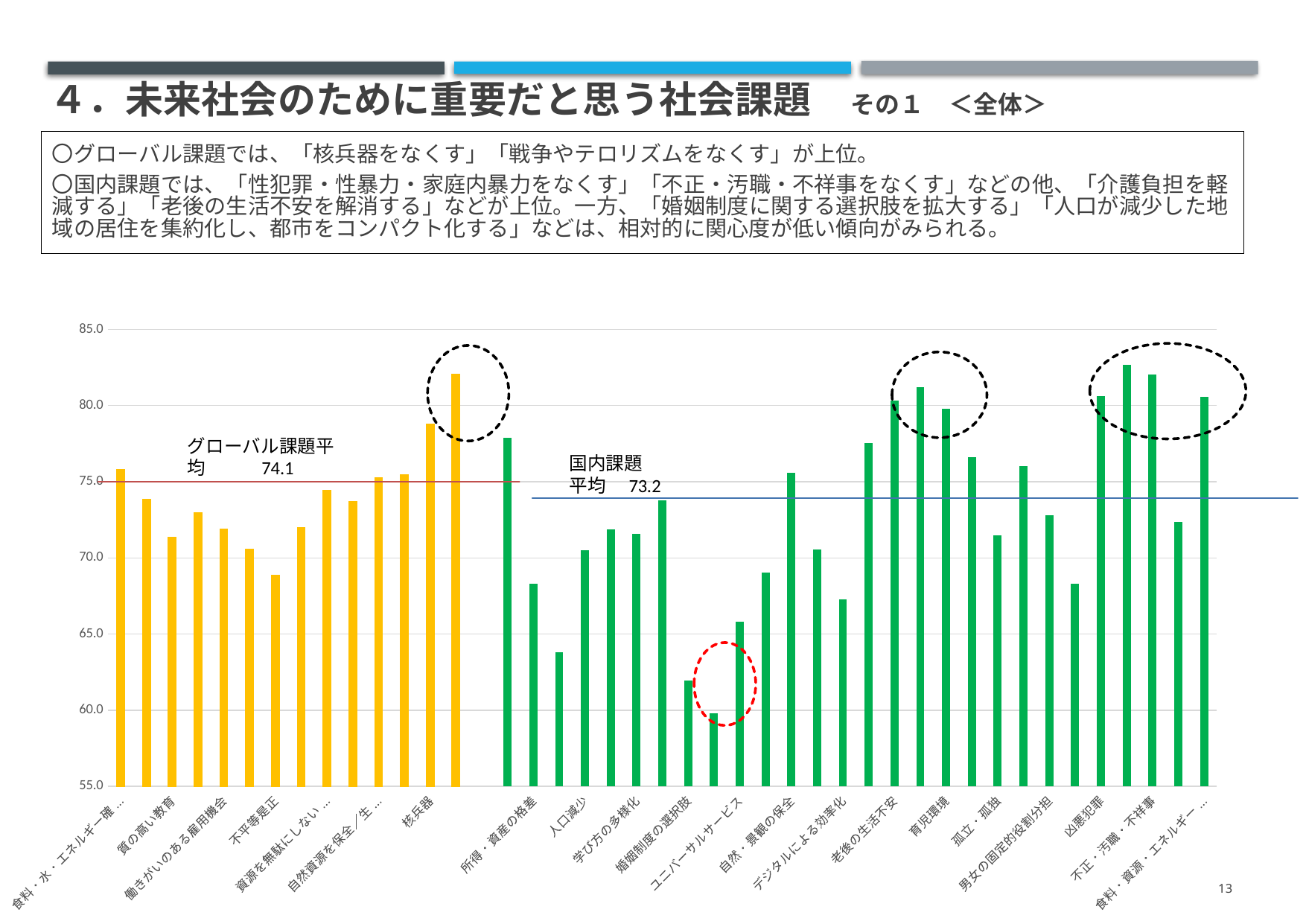
What is the difference between the global issues average (74.1) and the domestic issues average (73.2)? 0.9 Is the value for 核兵器 greater or less than 80? less What is the printed average for the global issues (グローバル課題平均)? 74.1 Is the value for 不平等是正 greater or less than 70? less What colour are the bars for the global issues (グローバル課題)? Yellow What is the printed average for the domestic issues (国内課題平均)? 73.2 What kind of chart is shown on the slide? Bar chart Which is larger, the value for 核兵器 or the value for 不平等是正? 核兵器 Which average is higher, the global issues average or the domestic issues average? グローバル課題平均 (74.1)